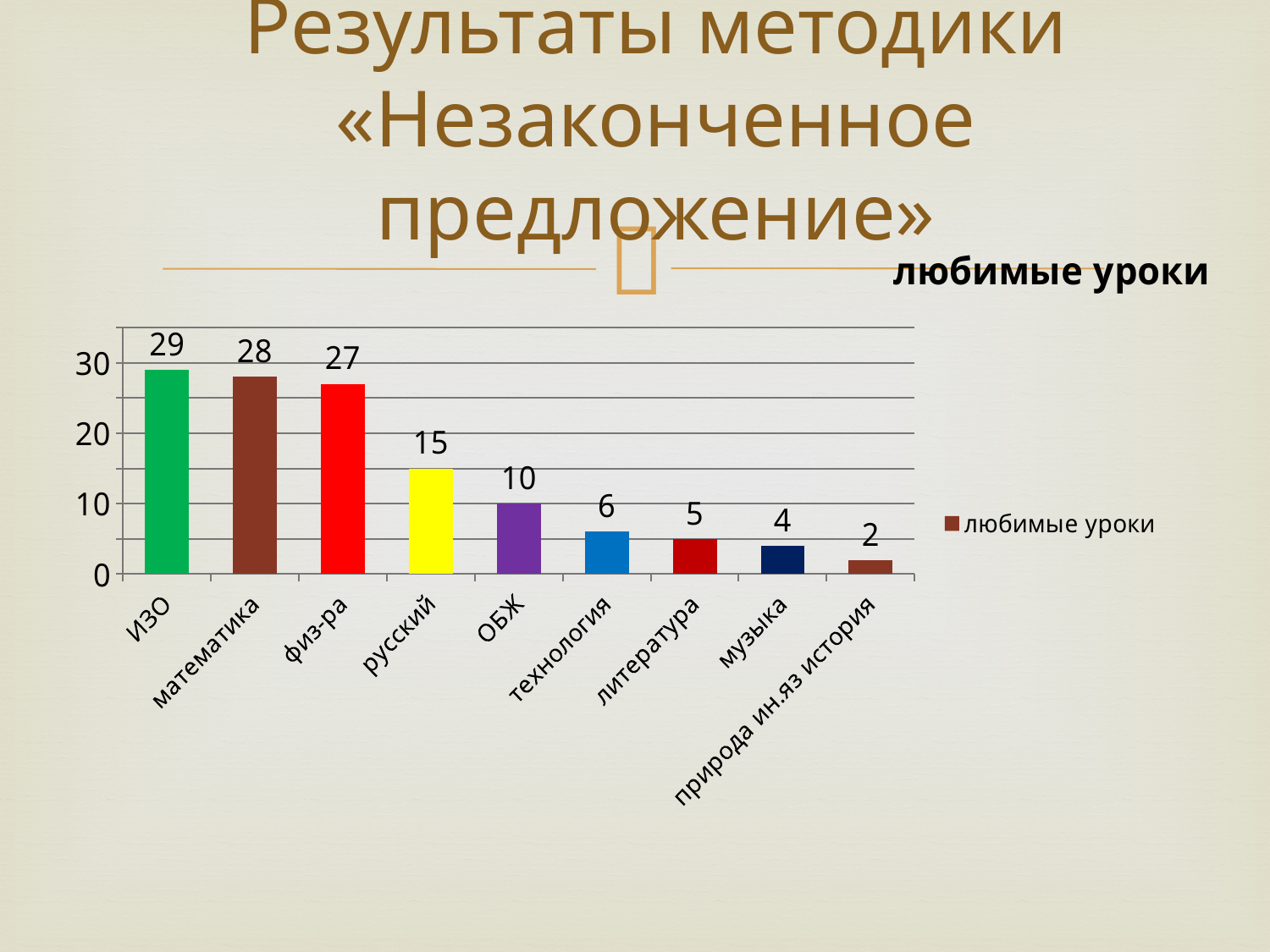
Do the values rise or fall from left to right along the x axis? fall Which is larger, the value for физ-ра or the value for русский? физ-ра How many categories are shown on the x axis? 9 What is the value for ИЗО? 29 Which category has the highest value? ИЗО How many series does the legend list? 1 What is the difference between the values for математика and ОБЖ? 18 What is the value for технология? 6 What kind of chart is shown? bar chart Is the value for литература greater or less than 10? less What is the value for русский? 15 Which category has the lowest value? природа ин.яз история